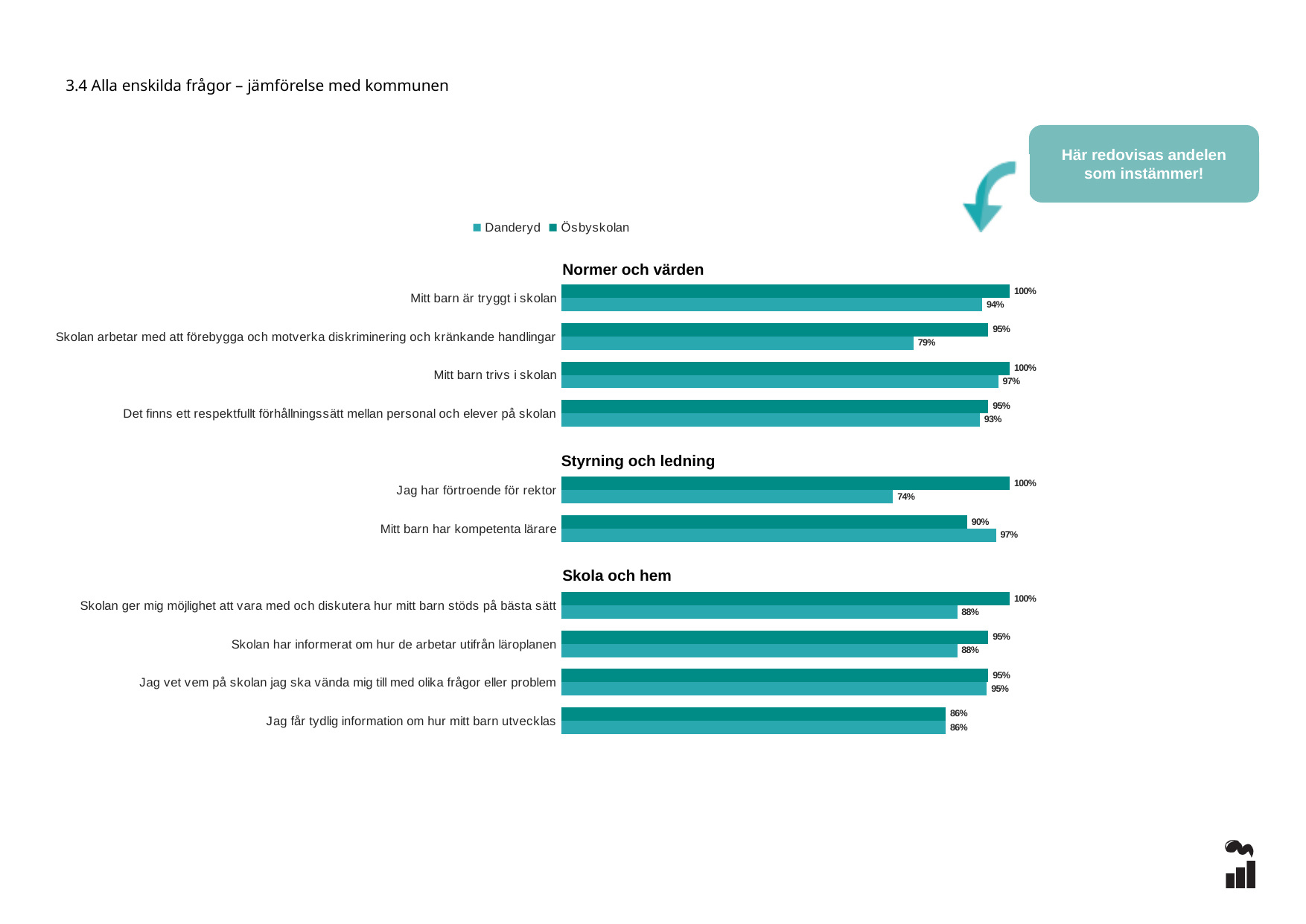
In the 'Normer och värden' chart, which question has the lowest Danderyd value? Skolan arbetar med att förebygga och motverka diskriminering och kränkande handlingar In the 'Normer och värden' chart, what is the Ösbyskolan value for 'Mitt barn är tryggt i skolan'? 100% What kind of chart is used on the slide? Bar chart In the 'Skola och hem' chart, how many questions are listed? 4 In the 'Normer och värden' chart, what is the difference between the Ösbyskolan and Danderyd values for 'Mitt barn trivs i skolan'? 3% In the 'Styrning och ledning' chart, what is the Danderyd value for 'Jag har förtroende för rektor'? 74% In the 'Normer och värden' chart, what is the Danderyd value for 'Skolan arbetar med att förebygga och motverka diskriminering och kränkande handlingar'? 79% In the 'Skola och hem' chart, what is the Danderyd value for 'Skolan har informerat om hur de arbetar utifrån läroplanen'? 88% How many series does the legend list? 2 In the 'Styrning och ledning' chart, what is the difference between the Ösbyskolan and Danderyd values for 'Jag har förtroende för rektor'? 26% In the 'Styrning och ledning' chart, which is larger for 'Mitt barn har kompetenta lärare': Danderyd or Ösbyskolan? Danderyd In the 'Skola och hem' chart, which question has the lowest Ösbyskolan value? Jag får tydlig information om hur mitt barn utvecklas